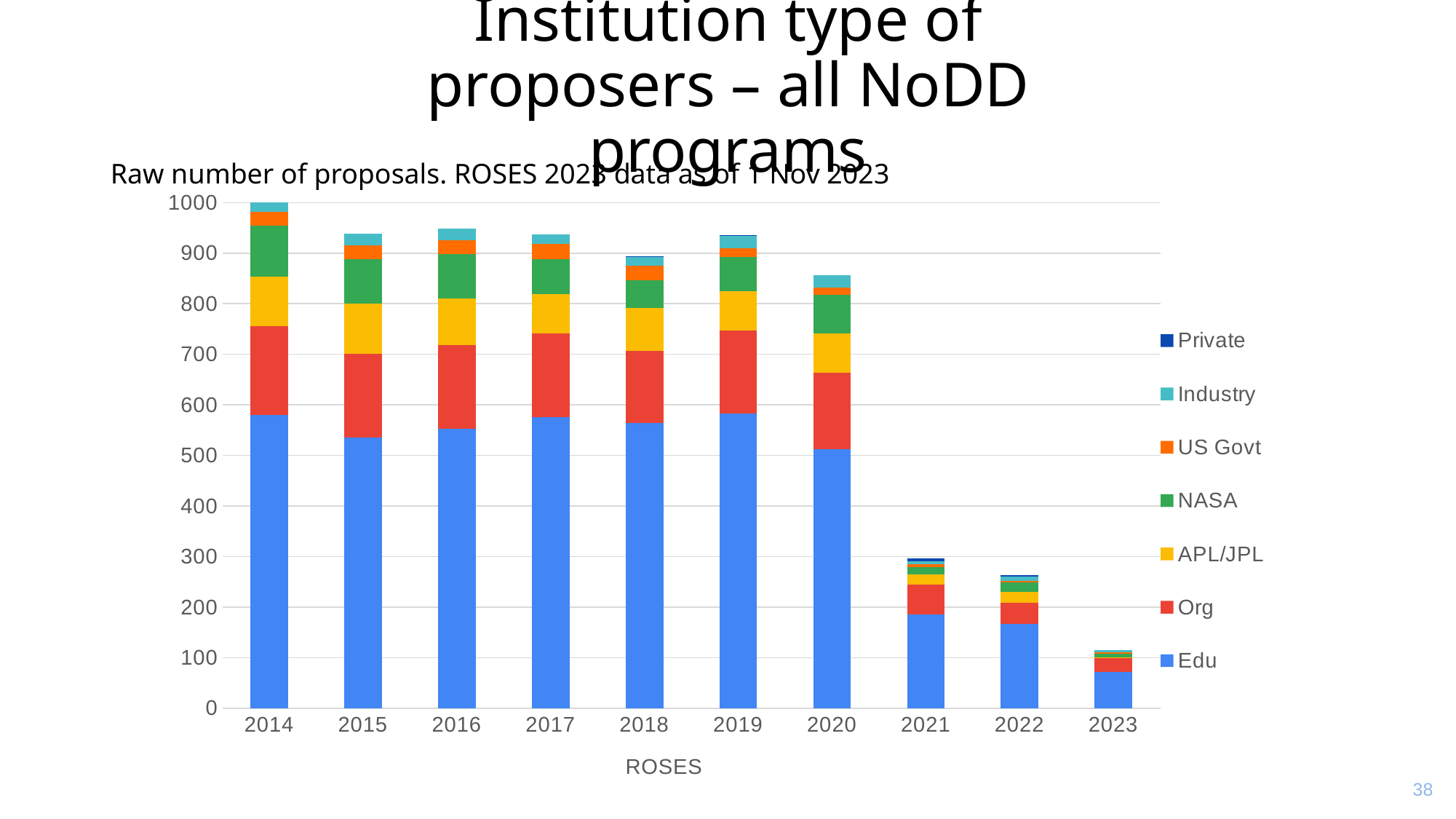
Which year has the larger total stacked bar, 2019 or 2021? 2019 Is the total stacked bar for 2020 greater or less than 800? greater Which year has the tallest stacked bar (highest total number of proposals)? 2014 How many series does the chart's legend list? 7 Is the total stacked bar for 2021 greater or less than 400? less What is the title of the x axis of the chart? ROSES What kind of chart is shown on the slide? Stacked bar chart Is the Edu value for 2014 greater or less than 500? greater How many years (categories) are shown on the x axis of the chart? 10 Which year has the shortest stacked bar (lowest total number of proposals)? 2023 Overall, do the total numbers of proposals rise or fall from 2014 to 2023? fall